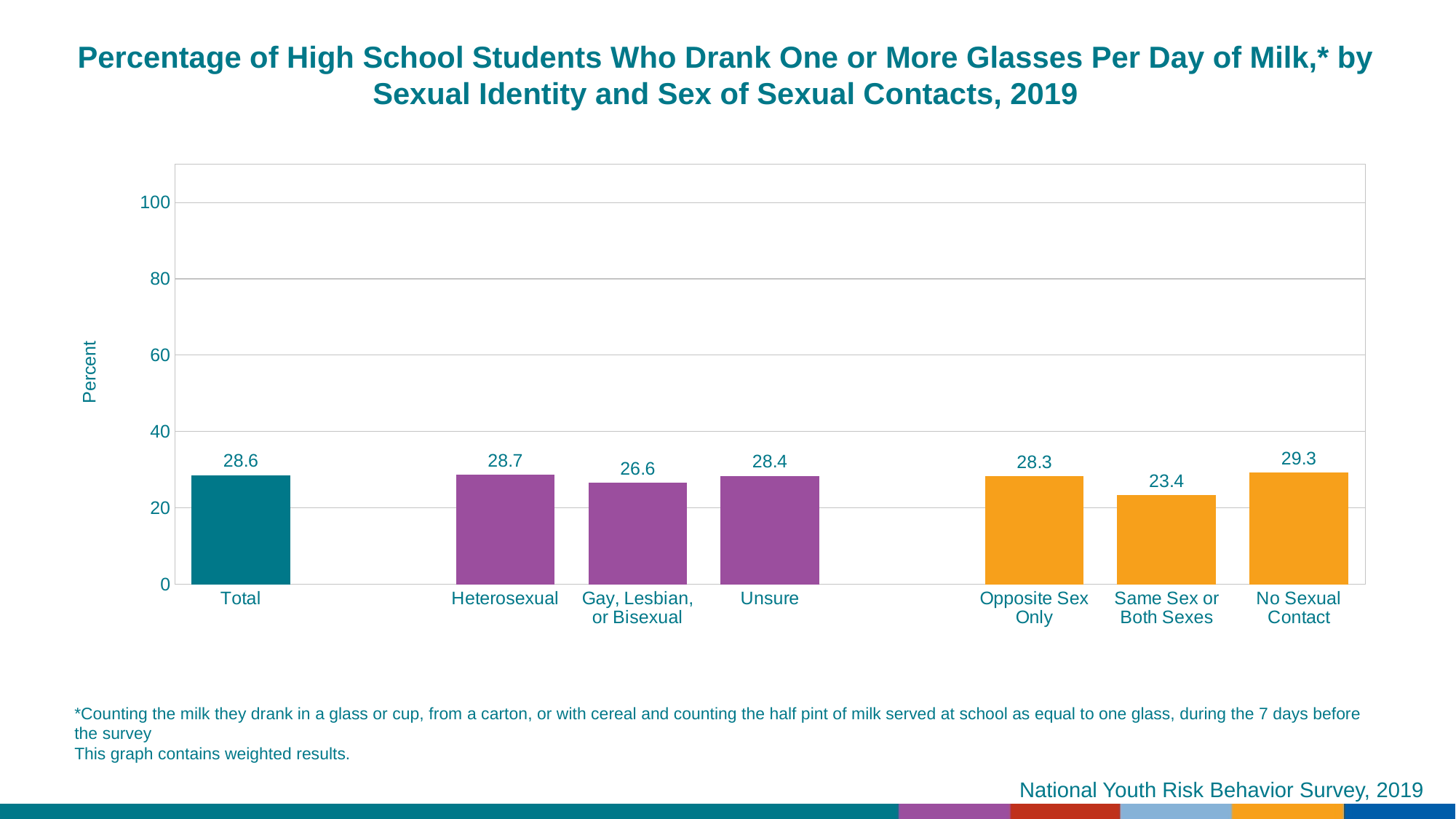
Which category has the highest value? No Sexual Contact How many categories are shown on the x axis? 7 What kind of chart is this? Bar chart What is the label on the y axis? Percent What is the value for Heterosexual? 28.7 Which is larger, the value for Unsure or the value for Gay, Lesbian, or Bisexual? Unsure What is the value for No Sexual Contact? 29.3 What is the value for Same Sex or Both Sexes? 23.4 What is the difference between the values for Opposite Sex Only and Same Sex or Both Sexes? 4.9 What is the value for Total? 28.6 What is the value for Gay, Lesbian, or Bisexual? 26.6 Which category has the lowest value? Same Sex or Both Sexes